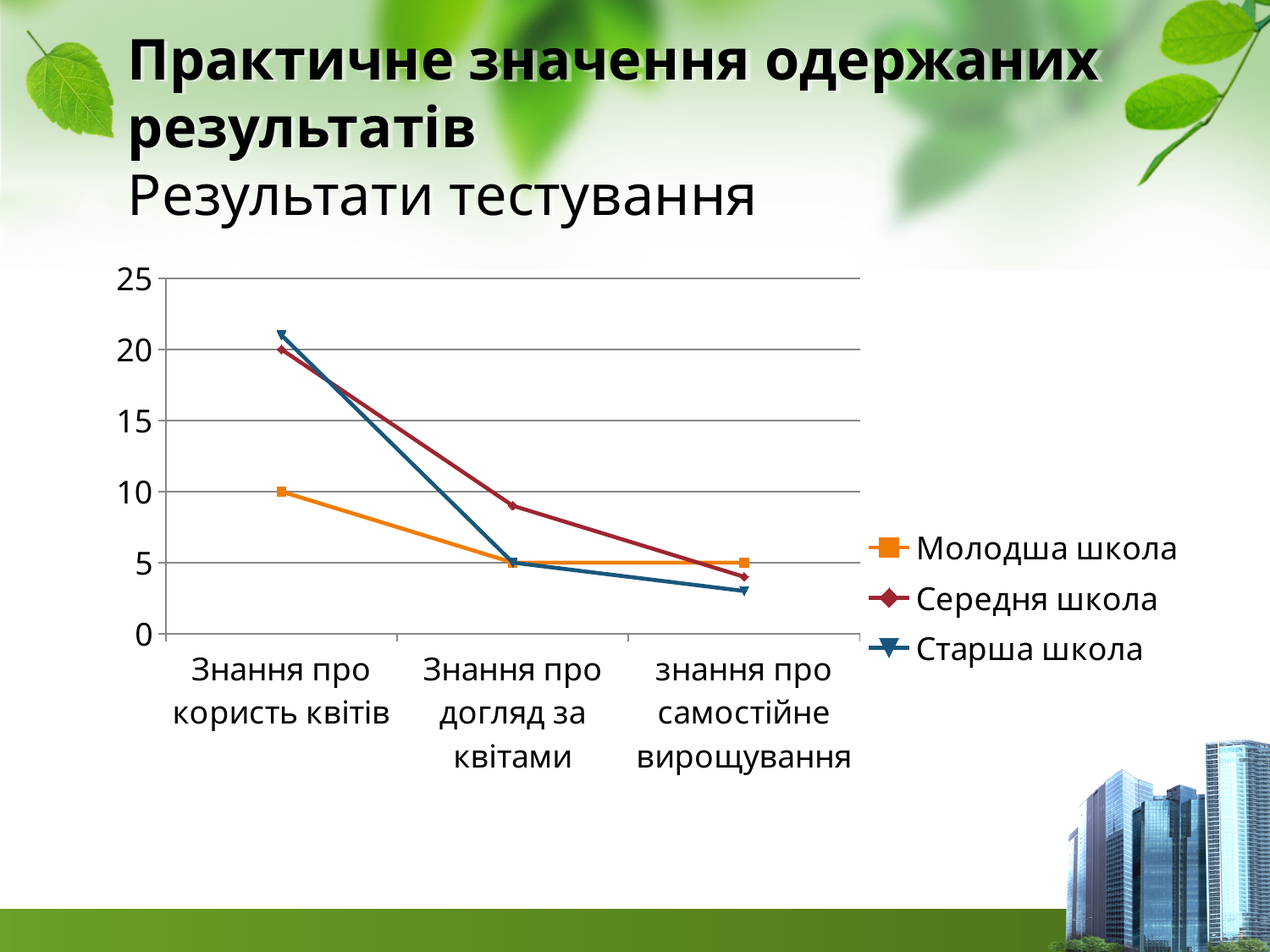
What is the value for Молодша школа for "Знання про догляд за квітами"? 5 What is the value for Середня школа for "Знання про користь квітів"? 20 Which series has the lowest value for "Знання про користь квітів"? Молодша школа Which series is drawn in orange? Молодша школа What is the value for Молодша школа for "Знання про користь квітів"? 10 Is the value for Середня школа for "Знання про догляд за квітами" greater or less than 10? less What kind of chart is shown on the slide? line chart Is the value for Старша школа for "Знання про користь квітів" greater or less than 20? greater Does the Середня школа line rise or fall across the categories from left to right? fall How many series does the legend list? 3 Is the value for Старша школа for "знання про самостійне вирощування" greater or less than 5? less How many categories are shown on the x axis? 3